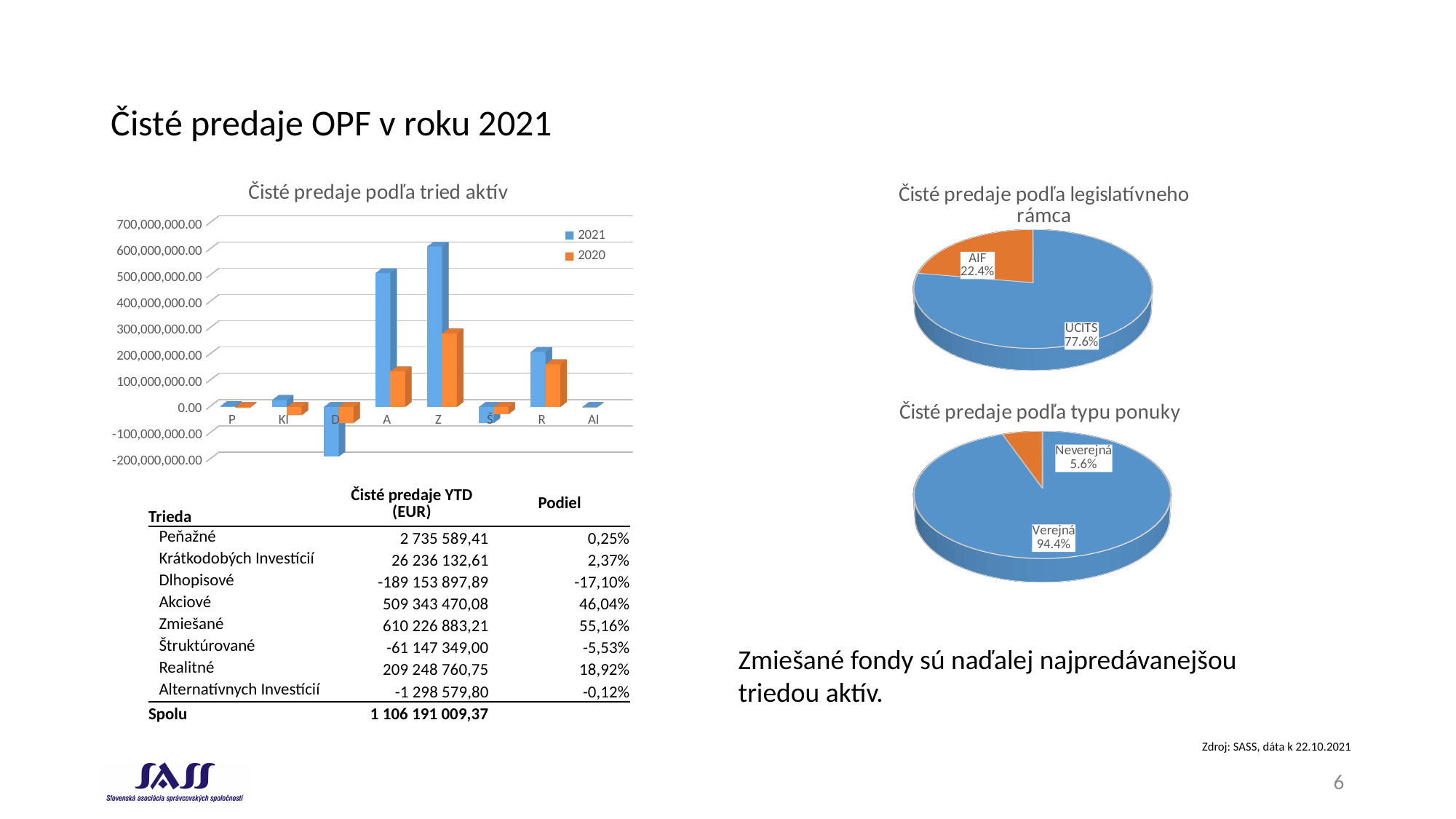
In the chart 'Čisté predaje podľa tried aktív', is the 2021 value for Z greater or less than 500,000,000.00? greater In the chart 'Čisté predaje podľa tried aktív', which category has the highest 2021 value? Z In the chart 'Čisté predaje podľa typu ponuky', what share does Neverejná have? 5.6% In the chart 'Čisté predaje podľa tried aktív', which category has the lowest 2021 value? D In the chart 'Čisté predaje podľa typu ponuky', which slice is the largest? Verejná In the chart 'Čisté predaje podľa tried aktív', is the 2021 value for D greater or less than -100,000,000.00? less In the chart 'Čisté predaje podľa tried aktív', which is larger for 2021: A or R? A In the chart 'Čisté predaje podľa legislatívneho rámca', what is the difference in percentage points between UCITS and AIF? 55.2 In the chart 'Čisté predaje podľa tried aktív', what kind of chart is it? bar chart In the chart 'Čisté predaje podľa tried aktív', how many categories are shown on the x axis? 8 In the chart 'Čisté predaje podľa tried aktív', how many series does the legend list? 2 In the chart 'Čisté predaje podľa legislatívneho rámca', what share does UCITS have? 77.6%